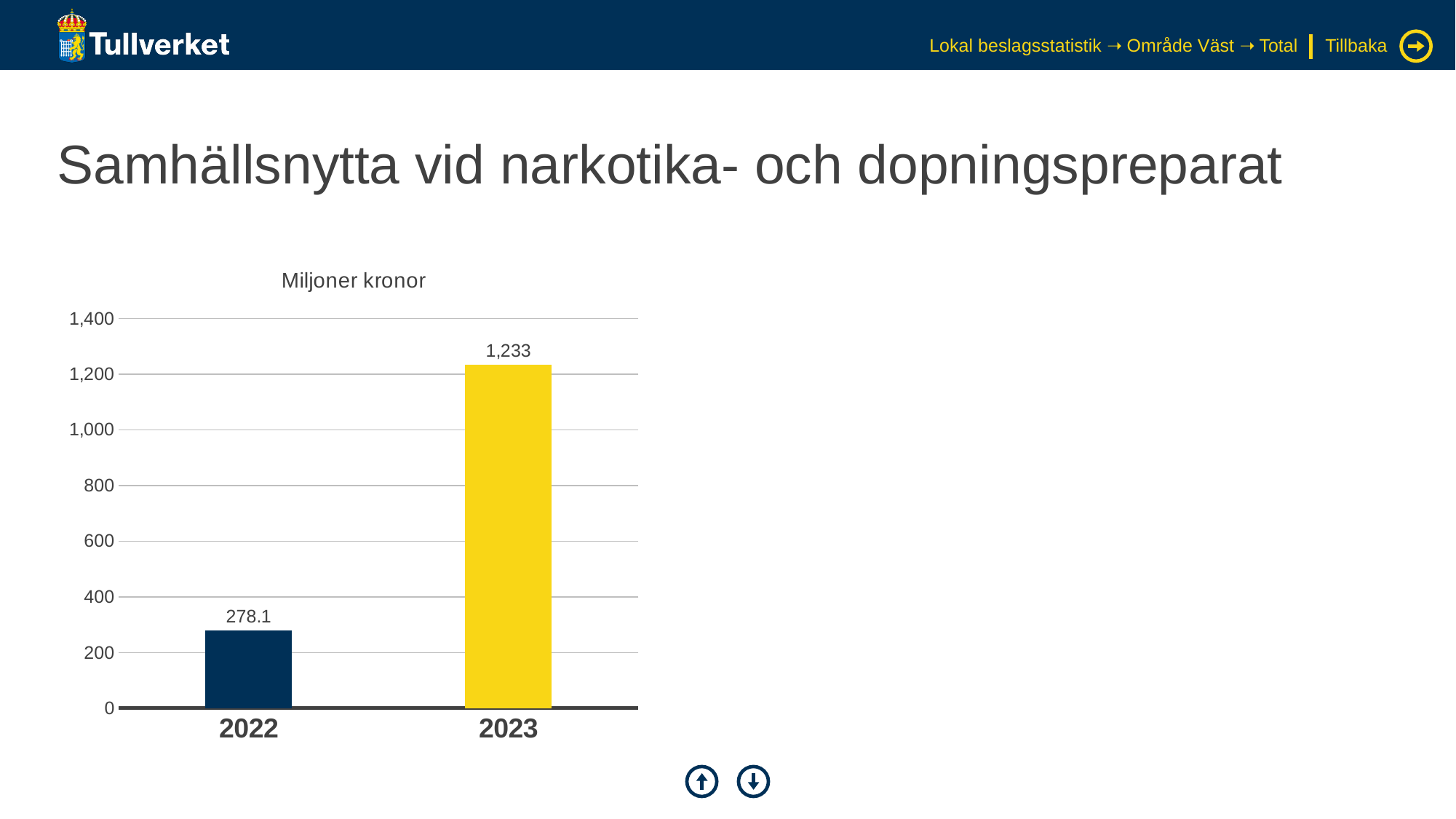
What kind of chart is shown on the slide? bar chart Which year has the highest value? 2023 Do the values rise or fall from 2022 to 2023? rise How many years are shown on the x axis? 2 What unit is given above the chart's y axis? Miljoner kronor What is the difference between the values for 2023 and 2022? 954.9 Which year has the lowest value? 2022 Is the value for 2023 greater or less than 1,000? greater What is the value for 2023? 1,233 Is the value for 2022 greater or less than 400? less What is the value for 2022? 278.1 Which is larger, the value for 2022 or the value for 2023? 2023